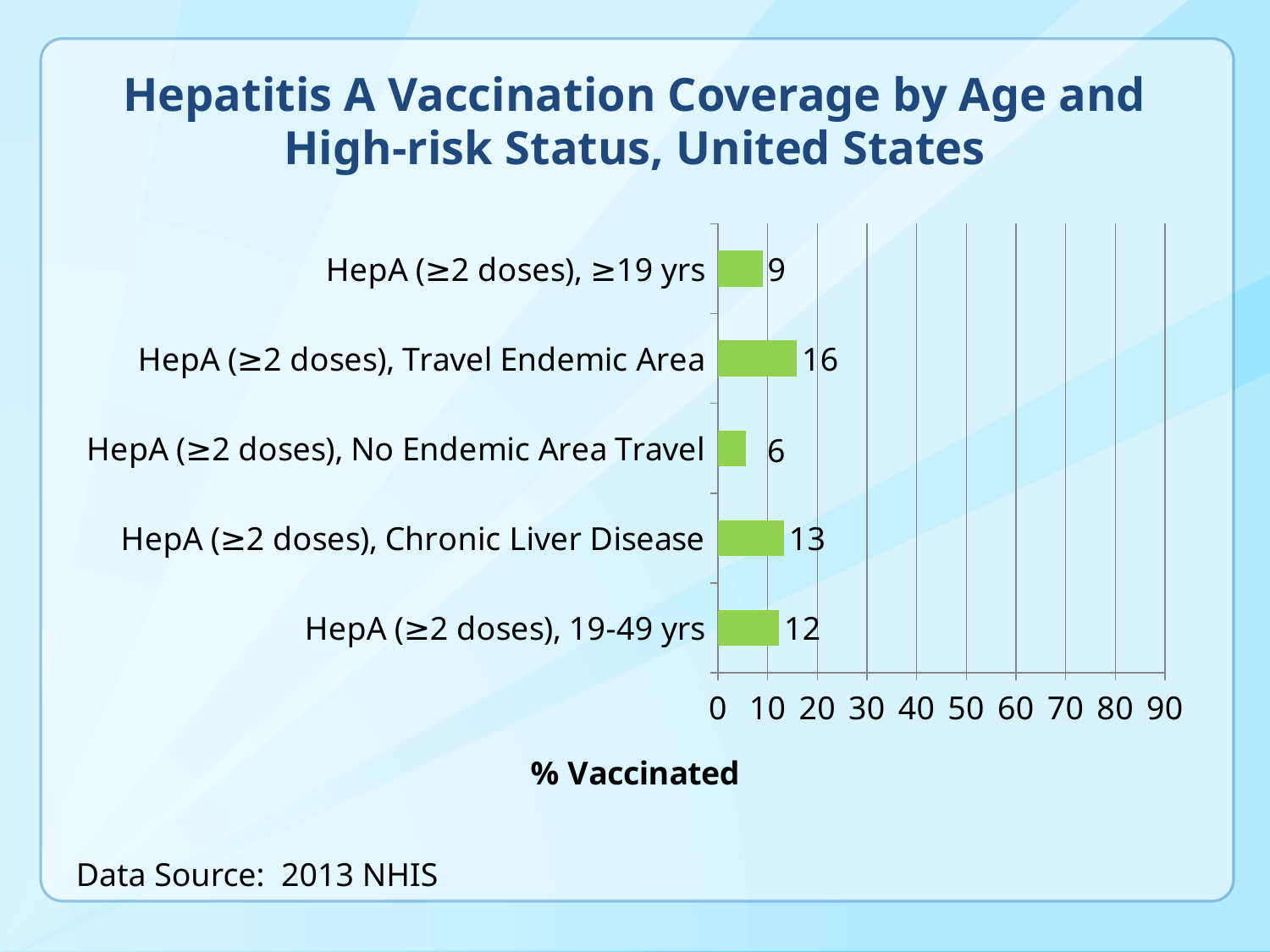
What is the label of the horizontal axis? % Vaccinated What is the % vaccinated for HepA (≥2 doses), Chronic Liver Disease? 13 Which category has the highest % vaccinated? HepA (≥2 doses), Travel Endemic Area Which category has the lowest % vaccinated? HepA (≥2 doses), No Endemic Area Travel What is the % vaccinated for HepA (≥2 doses), ≥19 yrs? 9 Which has a higher % vaccinated: Chronic Liver Disease or 19-49 yrs? Chronic Liver Disease What kind of chart is shown on the slide? Bar chart What is the % vaccinated for HepA (≥2 doses), Travel Endemic Area? 16 What is the % vaccinated for HepA (≥2 doses), 19-49 yrs? 12 Is the value for HepA (≥2 doses), Travel Endemic Area greater or less than 20? less What is the difference in % vaccinated between Travel Endemic Area and No Endemic Area Travel? 10 How many categories are shown in the chart? 5